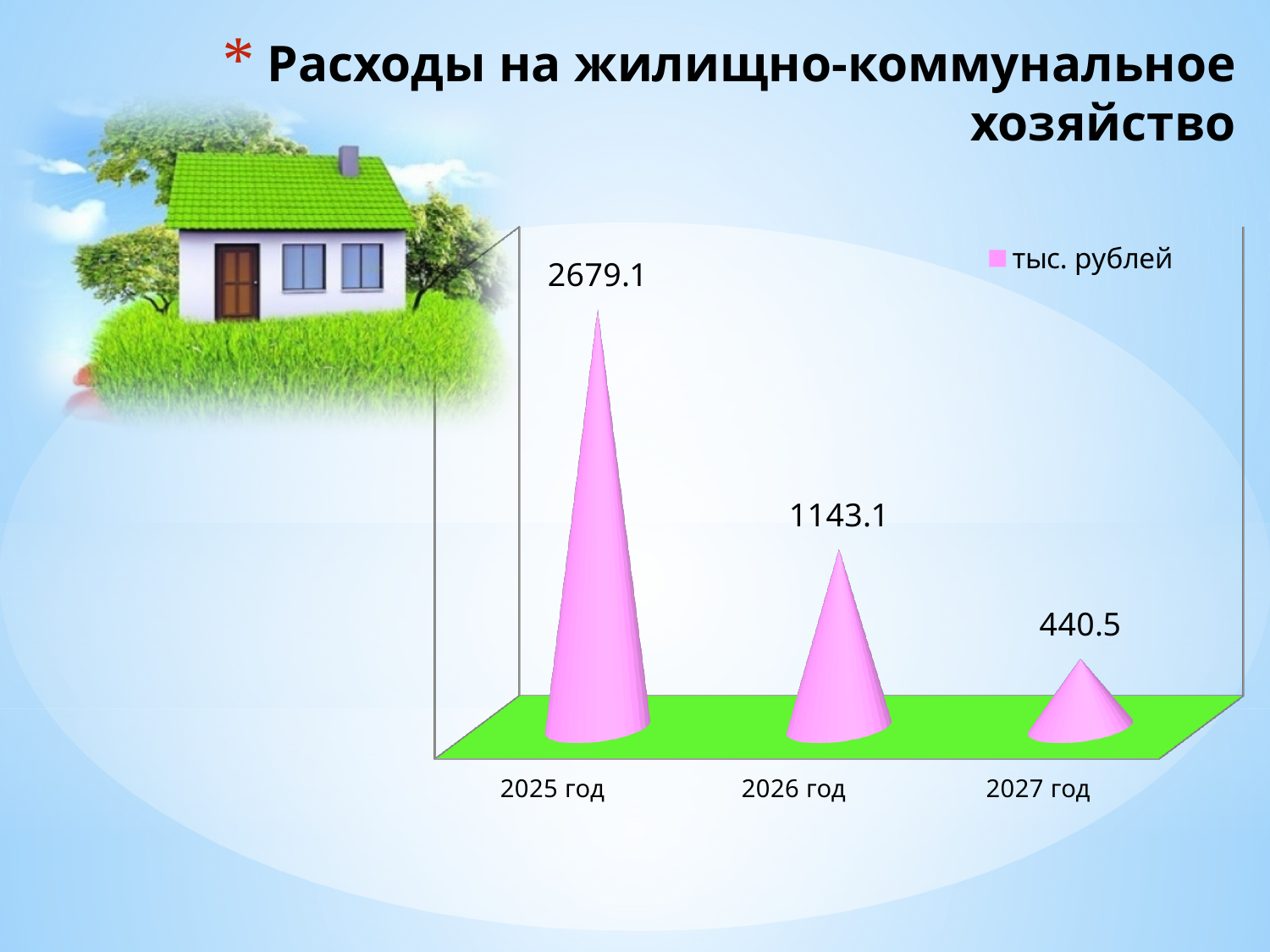
Do the values rise or fall from 2025 год to 2027 год? fall What is the difference between the values for 2025 год and 2026 год? 1536.0 Which year has the lowest value? 2027 год How many series does the legend list? 1 What is the value for 2027 год? 440.5 What is the difference between the values for 2026 год and 2027 год? 702.6 Which year has the highest value? 2025 год What is the value for 2025 год? 2679.1 What is the value for 2026 год? 1143.1 What is the legend entry for the series? тыс. рублей How many categories are shown on the x axis? 3 Which is larger, the value for 2026 год or the value for 2027 год? 2026 год